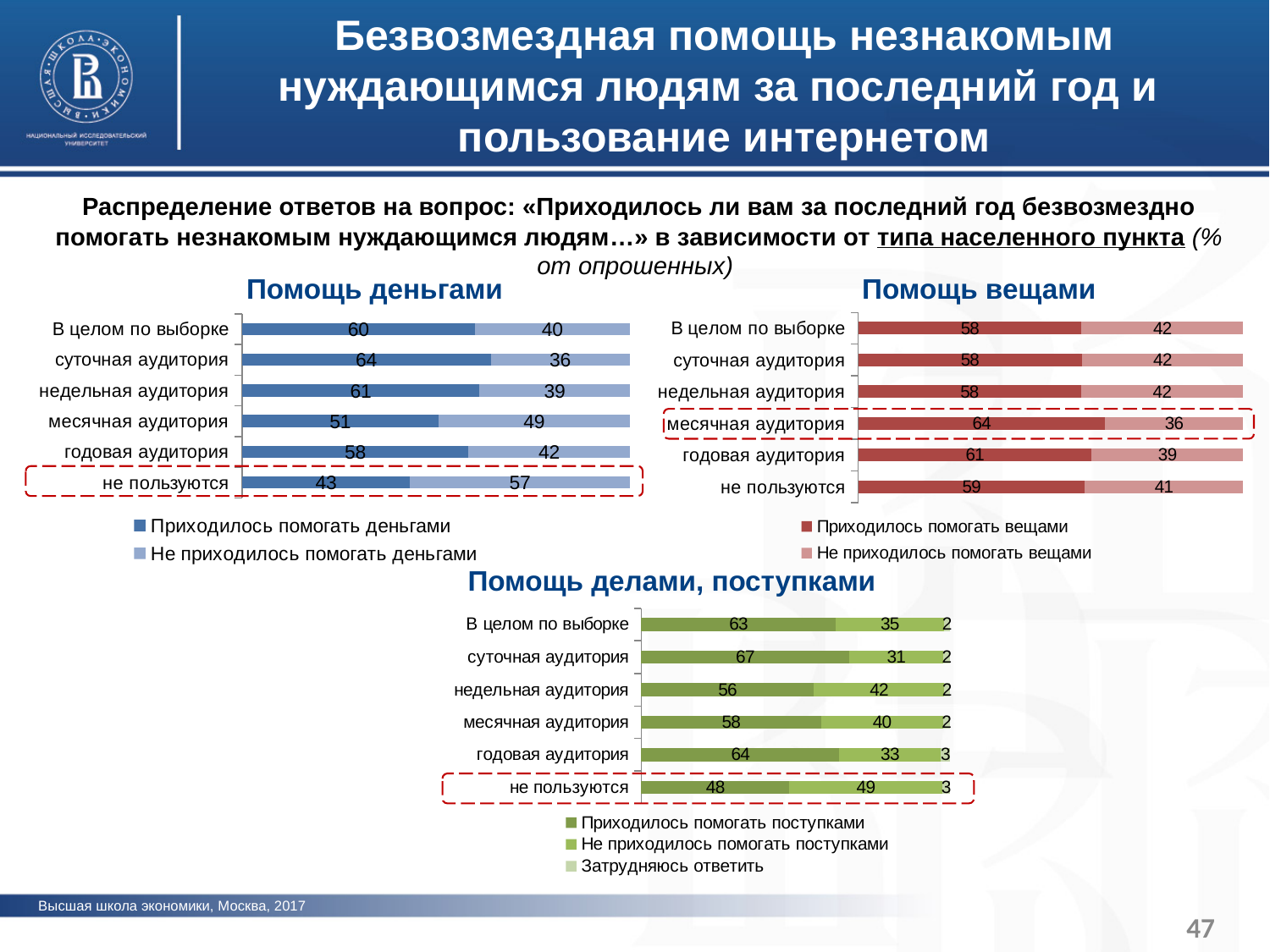
In the "Помощь делами, поступками" chart, how many series does the legend list? 3 In the "Помощь делами, поступками" chart, what is the value of "Затрудняюсь ответить" for "годовая аудитория"? 3 In the "Помощь делами, поступками" chart, what is the total of the stacked bar for "не пользуются"? 100 In the "Помощь делами, поступками" chart, which is larger for "недельная аудитория": "Приходилось помогать поступками" or "Не приходилось помогать поступками"? Приходилось помогать поступками In the "Помощь вещами" chart, which category has the highest value for "Приходилось помогать вещами"? месячная аудитория What type of chart is "Помощь вещами"? Stacked bar chart How many categories are shown in the "Помощь деньгами" chart? 6 In the "Помощь деньгами" chart, what is the value of "Приходилось помогать деньгами" for "месячная аудитория"? 51 In the "Помощь вещами" chart, what is the value of "Не приходилось помогать вещами" for "годовая аудитория"? 39 In the "Помощь вещами" chart, what is the difference between "Приходилось помогать вещами" and "Не приходилось помогать вещами" for "не пользуются"? 18 In the "Помощь деньгами" chart, which category has the lowest value for "Приходилось помогать деньгами"? не пользуются In the "Помощь деньгами" chart, which category has the highest value for "Приходилось помогать деньгами"? суточная аудитория